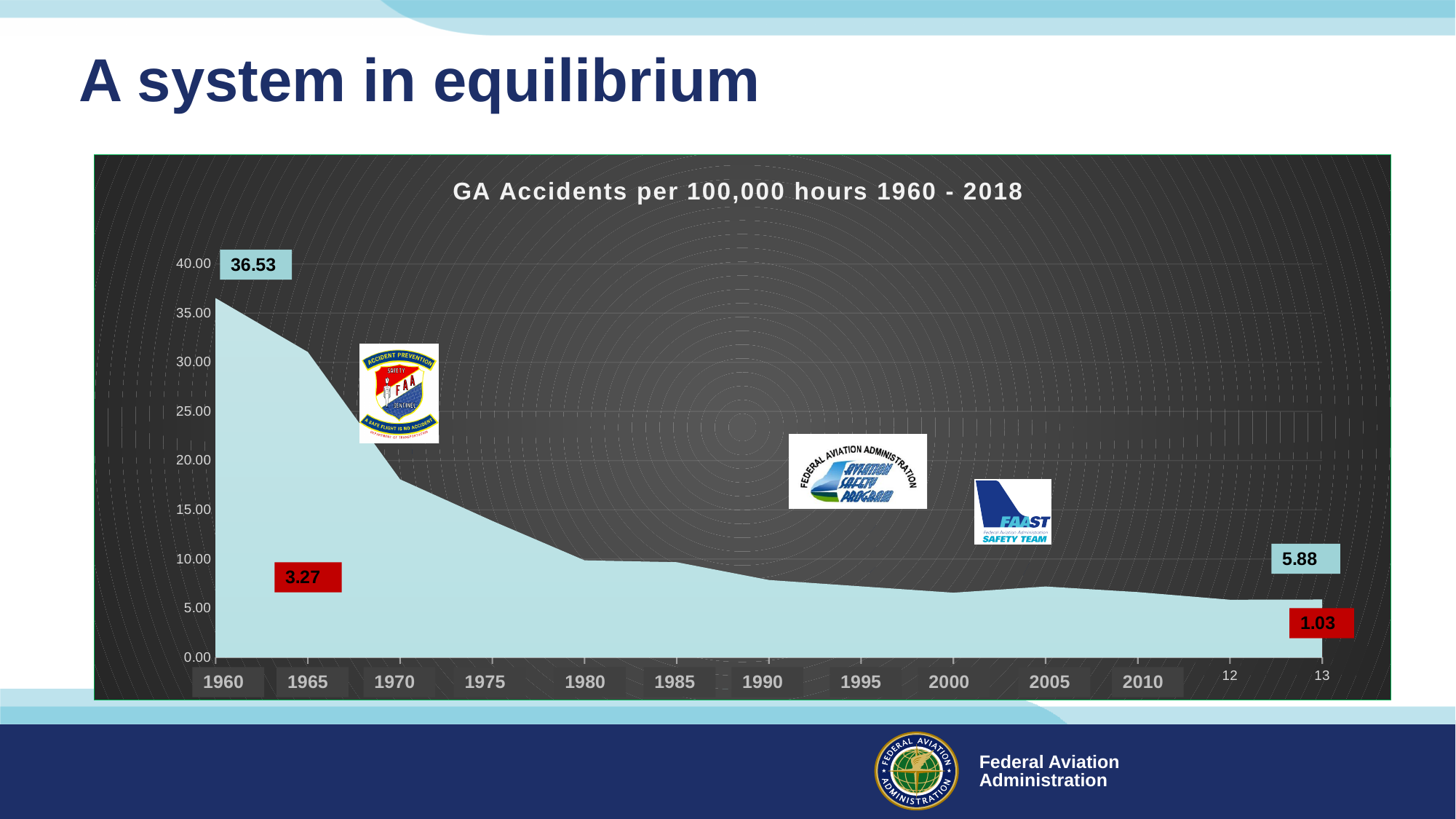
What is the title of the chart? GA Accidents per 100,000 hours 1960 - 2018 How many tick labels are shown along the x axis? 13 What kind of chart is shown on the slide? area chart Is the value for 1960 greater or less than 35? greater Which has the higher accident rate, 1975 or 2005? 1975 Which year on the x axis has the highest accident rate? 1960 Is the value for 1990 greater or less than 10? less What value is printed in the light-blue label at the right end of the chart? 5.88 Is the value for 1970 greater or less than 20? less What value is printed in the label at the start of the chart, for 1960? 36.53 Do the accident rate values rise or fall from 1960 to the right end of the chart? fall